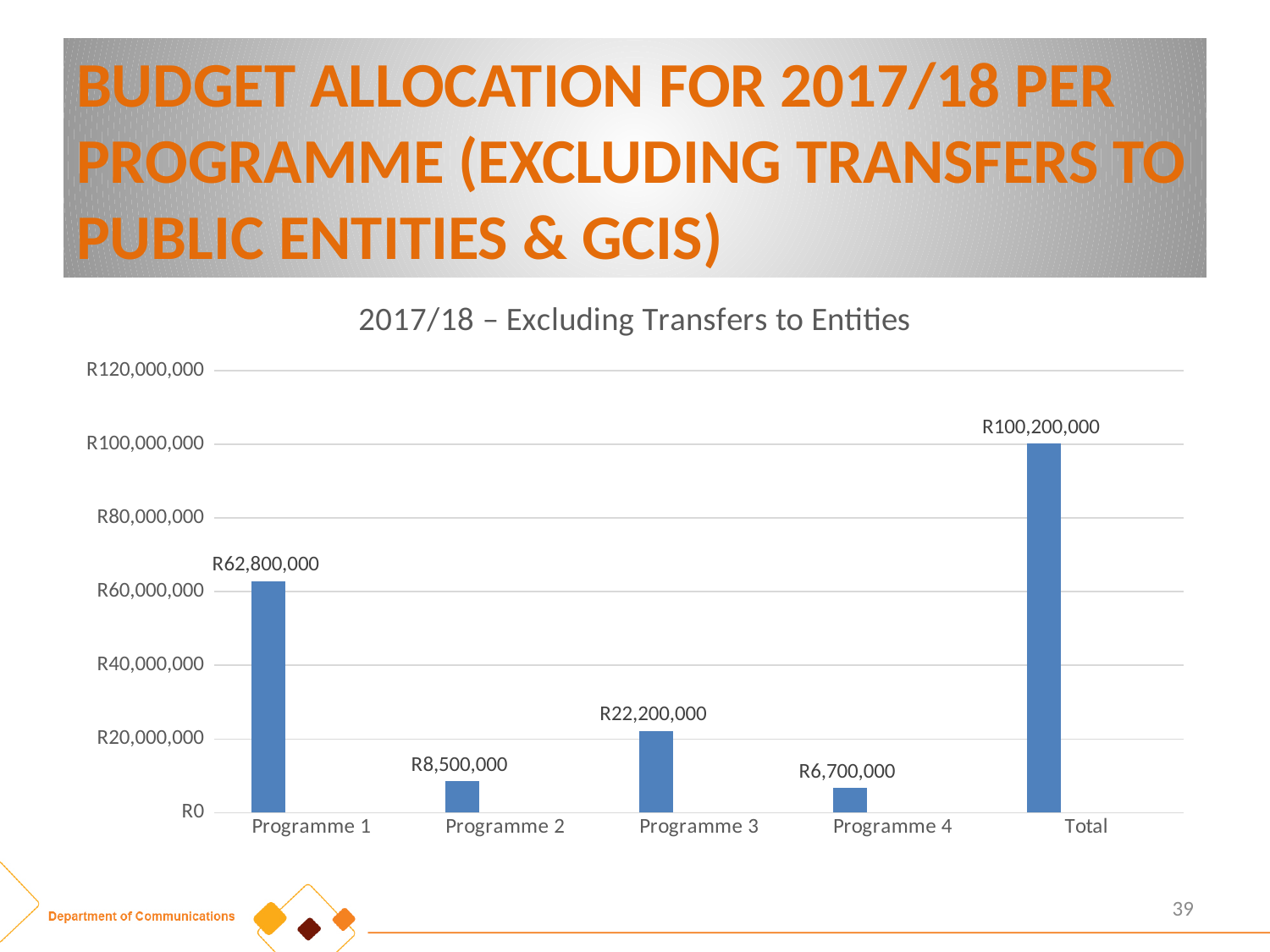
What is the value for Programme 1? R62,800,000 Which programme has the highest budget allocation? Programme 1 What type of chart is shown on the slide? Bar chart What is the difference between Programme 2 and Programme 4? R1,800,000 Which programme has the lowest budget allocation? Programme 4 What is the value shown for Total? R100,200,000 Is the value for Programme 1 greater or less than R60,000,000? greater How many bars are shown in the chart? 5 Which is larger, Programme 2 or Programme 3? Programme 3 What is the difference between Programme 1 and Programme 3? R40,600,000 What is the value for Programme 3? R22,200,000 What is the value for Programme 4? R6,700,000